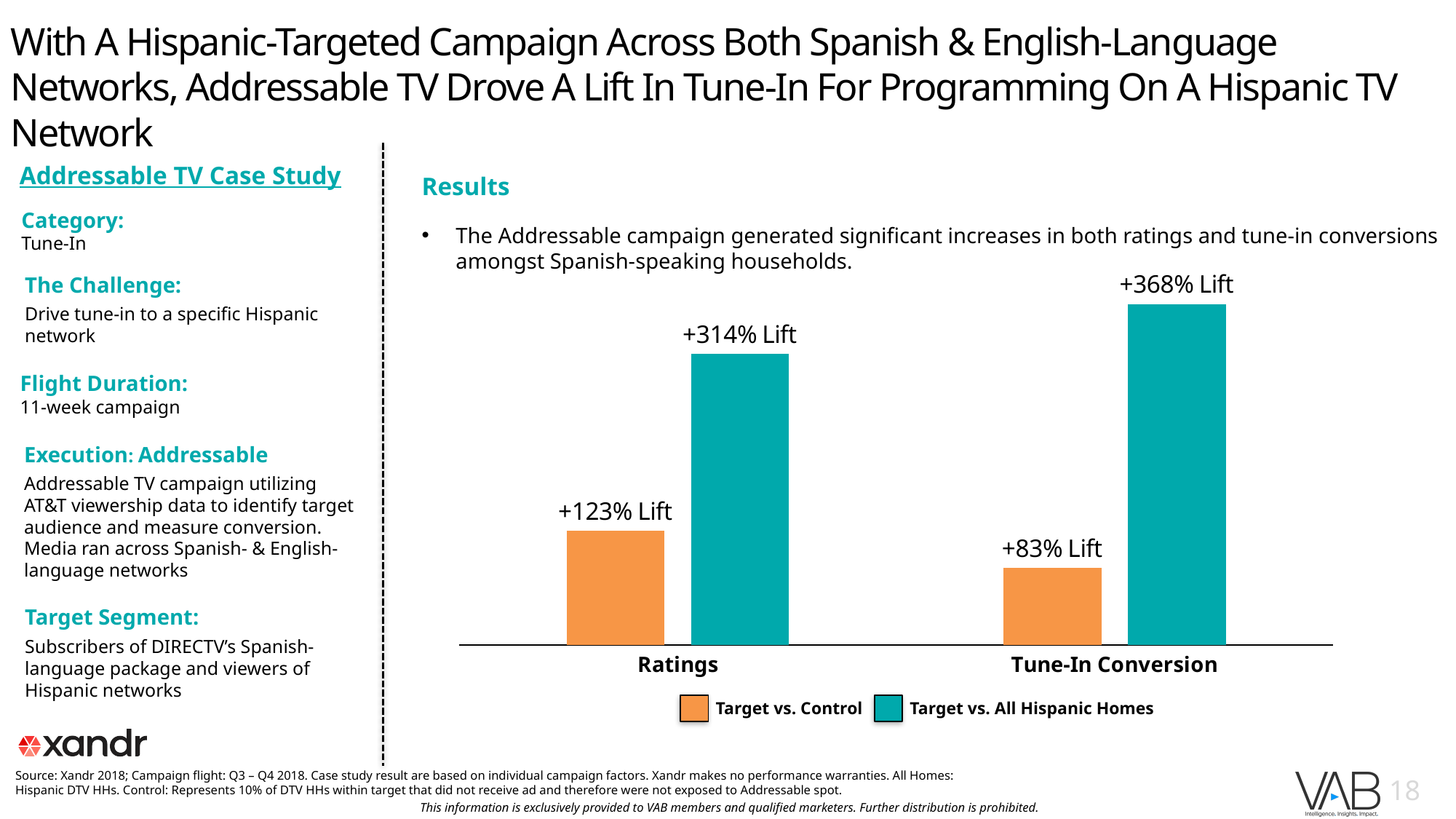
Which bar shows the highest lift on the chart? Target vs. All Hispanic Homes, Tune-In Conversion Which bar shows the lowest lift on the chart? Target vs. Control, Tune-In Conversion What is the lift for Target vs. Control in the Tune-In Conversion category? +83% Lift What is the difference in lift between Target vs. All Hispanic Homes and Target vs. Control in the Tune-In Conversion category? 285% What type of chart is shown on the slide? Bar chart Which is larger: the Target vs. Control lift for Ratings or for Tune-In Conversion? Ratings What is the difference in lift between Target vs. All Hispanic Homes and Target vs. Control in the Ratings category? 191% How many series does the chart legend list? 2 What is the lift for Target vs. Control in the Ratings category? +123% Lift What is the lift for Target vs. All Hispanic Homes in the Ratings category? +314% Lift What is the lift for Target vs. All Hispanic Homes in the Tune-In Conversion category? +368% Lift How many categories are shown on the x axis of the chart? 2